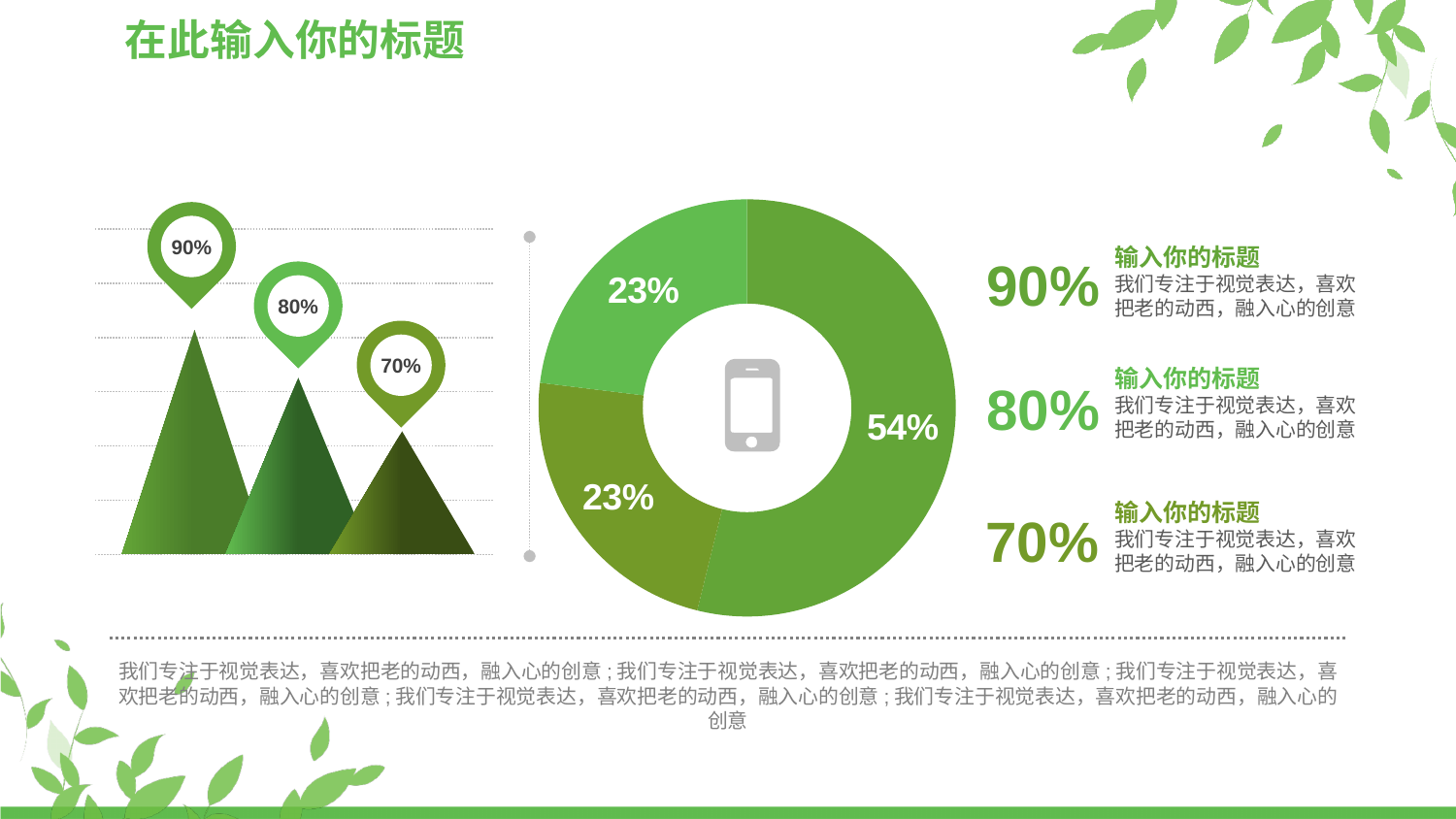
In the triangle chart on the left of the slide, do the labelled values rise or fall from left to right? Fall What icon is shown in the centre of the donut chart? A mobile phone What kind of chart is the chart in the centre of the slide? Donut (pie) chart In the donut chart in the centre of the slide, what do the two 23% slices add up to? 46% In the donut chart in the centre of the slide, is the 54% slice larger or smaller than half of the whole? Larger What is the value labelled on the tallest triangle in the chart on the left of the slide? 90% In the donut chart in the centre of the slide, what is the difference between the largest slice (54%) and one of the 23% slices? 31 percentage points What is the value of the largest slice in the donut chart in the centre of the slide? 54% How many slices does the donut chart in the centre of the slide have? 3 How many triangles (data points) are shown in the triangle chart on the left of the slide? 3 What is the value of the smallest slices in the donut chart in the centre of the slide? 23% What is the value labelled on the shortest triangle in the chart on the left of the slide? 70%